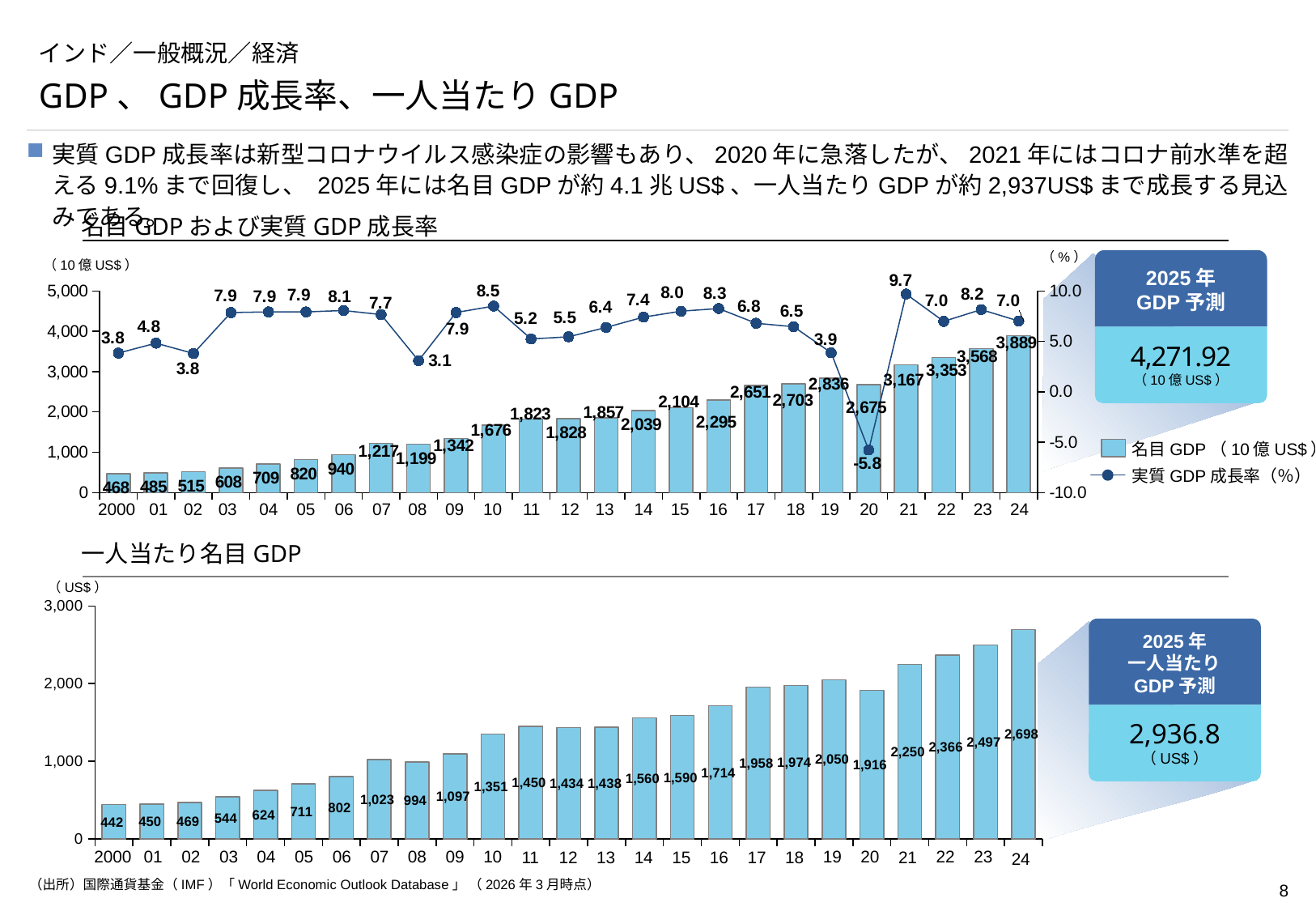
In the bottom chart (一人当たり名目GDP), what is the difference in per capita nominal GDP between 2019 and 2020? 134 In the top chart (名目GDPおよび実質GDP成長率), what is the real GDP growth rate for 2020? -5.8 In the top chart (名目GDPおよび実質GDP成長率), what is the nominal GDP value for 2024? 3,889 In the top chart (名目GDPおよび実質GDP成長率), which year has the lowest nominal GDP? 2000 In the top chart (名目GDPおよび実質GDP成長率), what is the difference in nominal GDP between 2024 and 2023? 321 What type of chart is the bottom chart (一人当たり名目GDP)? bar chart In the bottom chart (一人当たり名目GDP), what is the per capita nominal GDP for 2024? 2,698 In the top chart (名目GDPおよび実質GDP成長率), how many series does the legend list? 2 In the top chart (名目GDPおよび実質GDP成長率), which year has the highest real GDP growth rate? 21 In the bottom chart (一人当たり名目GDP), how many years are plotted? 25 In the bottom chart (一人当たり名目GDP), what is the per capita nominal GDP for 2020? 1,916 In the top chart (名目GDPおよび実質GDP成長率), is the real GDP growth rate for 2008 higher or lower than for 2009? lower